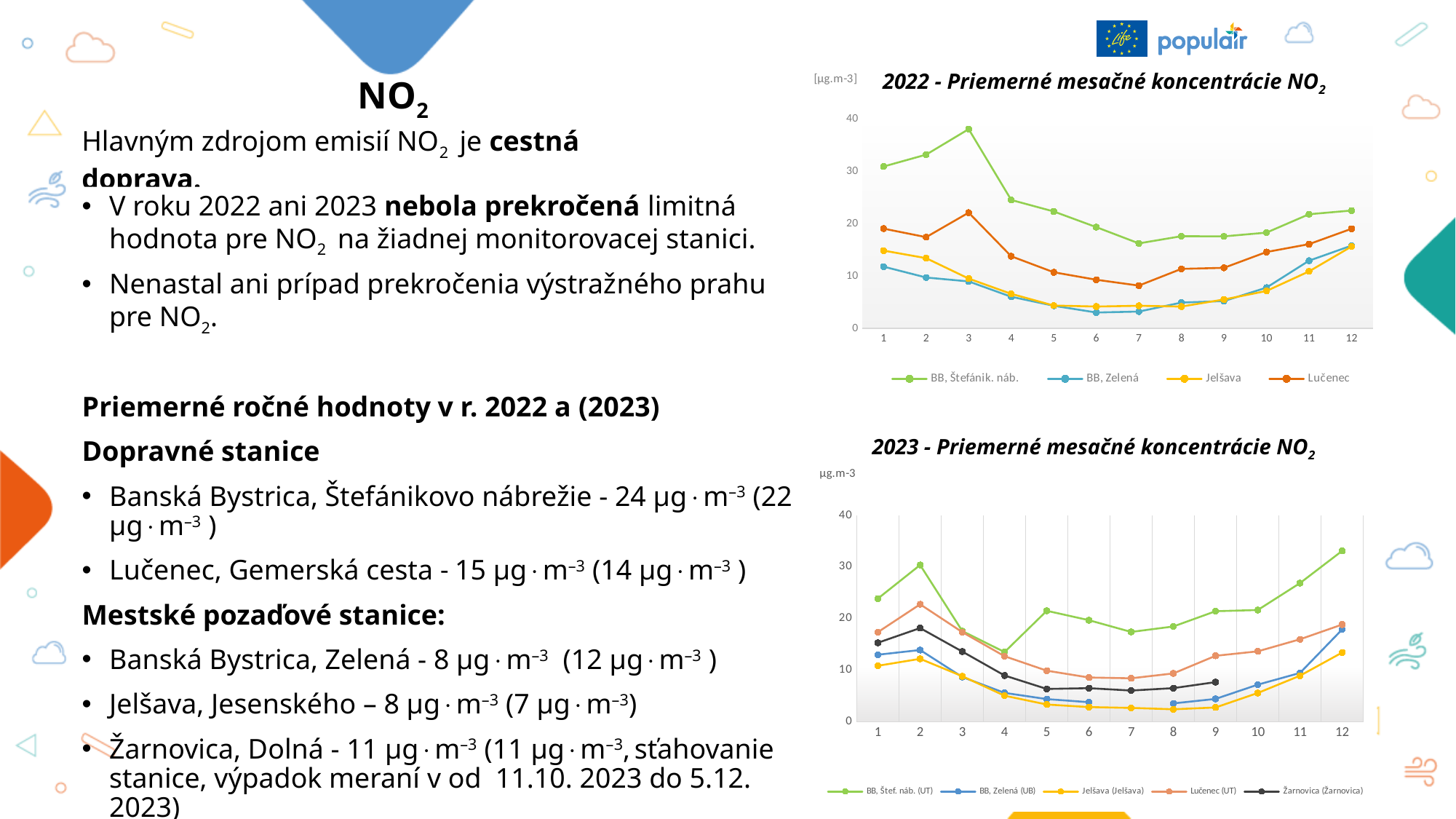
In the 2022 chart, in which month does the 'BB, Štefánik. náb.' series reach its highest value? 3 How many series does the legend of the 2023 chart list? 5 In the 2023 chart, is the value for 'BB, Štef. náb. (UT)' in month 12 greater or less than 30? greater How many series does the legend of the 2022 chart list? 4 How many months are shown on the x axis of the 2022 chart? 12 In the 2023 chart, what is the last month for which the 'Žarnovica (Žarnovica)' series has a plotted point? 9 In the 2022 chart, is the value for 'BB, Štefánik. náb.' in month 3 greater or less than 30? greater In the 2022 chart, does the 'BB, Zelená' series rise or fall from month 1 to month 6? fall In the 2022 chart, which series has the larger value in month 1: 'BB, Štefánik. náb.' or 'Lučenec'? BB, Štefánik. náb. In the 2022 chart, is the value for 'Jelšava' in month 7 greater or less than 10? less In the 2023 chart, which series has the highest value in month 12? BB, Štef. náb. (UT) What kind of chart is the '2022 - Priemerné mesačné koncentrácie NO2' chart? line chart